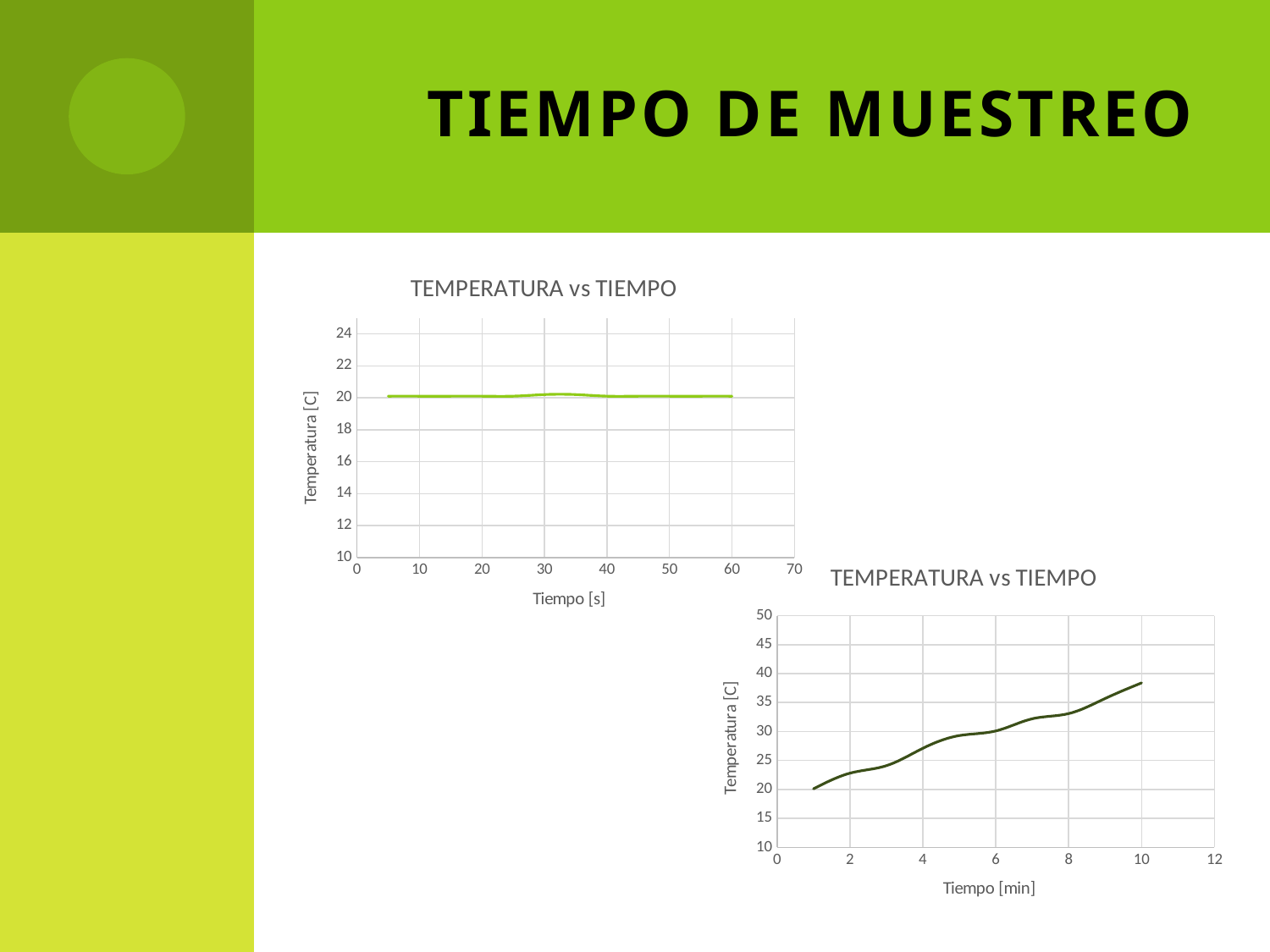
In the lower-right chart (Tiempo [min]), is the temperature at 10 min greater or less than 35? greater What kind of chart is the upper-left chart with the x axis labelled Tiempo [s]? line chart In the lower-right chart (Tiempo [min]), is the temperature at 1 min greater or less than 25? less In the lower-right chart (Tiempo [min]), is the temperature at 6 min greater or less than 25? greater What kind of chart is the lower-right chart with the x axis labelled Tiempo [min]? line chart What is the y-axis label of the upper-left chart? Temperatura [C] What is the x-axis label of the lower-right chart? Tiempo [min] In the lower-right chart (Tiempo [min]), which is larger: the temperature at 2 min or at 10 min? 10 min In the lower-right chart (Tiempo [min]), do the temperature values rise or fall as time increases? rise In the upper-left chart (Tiempo [s]), does the temperature rise, fall, or stay roughly flat as time increases? stay roughly flat